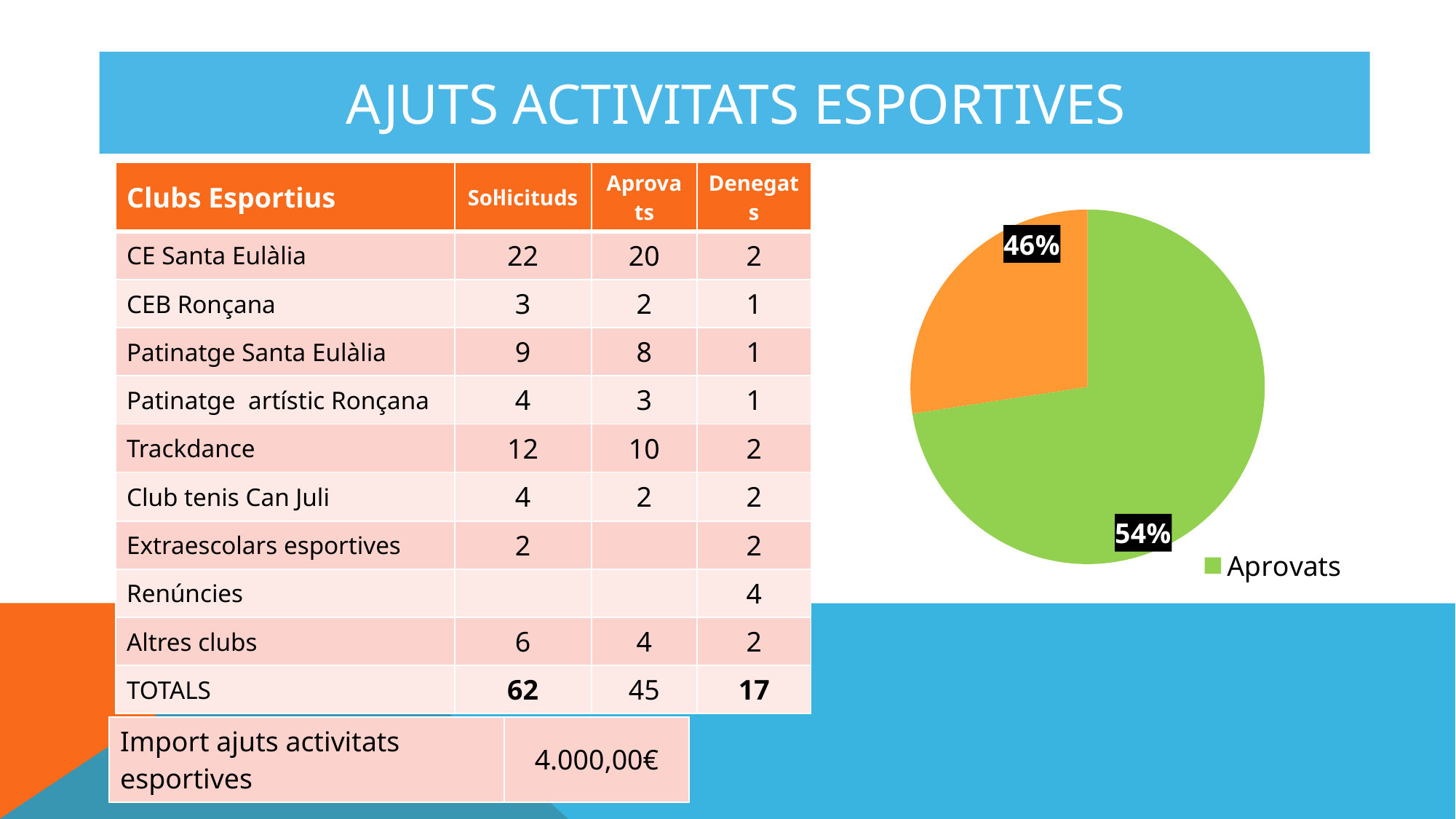
What percentage is printed on the orange slice of the pie chart? 46% How many entries does the pie chart's legend list? 1 Which slice of the pie chart is the largest? Aprovats What is the only entry shown in the pie chart's legend? Aprovats What colour is the Aprovats slice in the pie chart? green What kind of chart is shown on the slide? pie chart How many slices does the pie chart have? 2 Is the share for Aprovats greater or less than 50%? greater